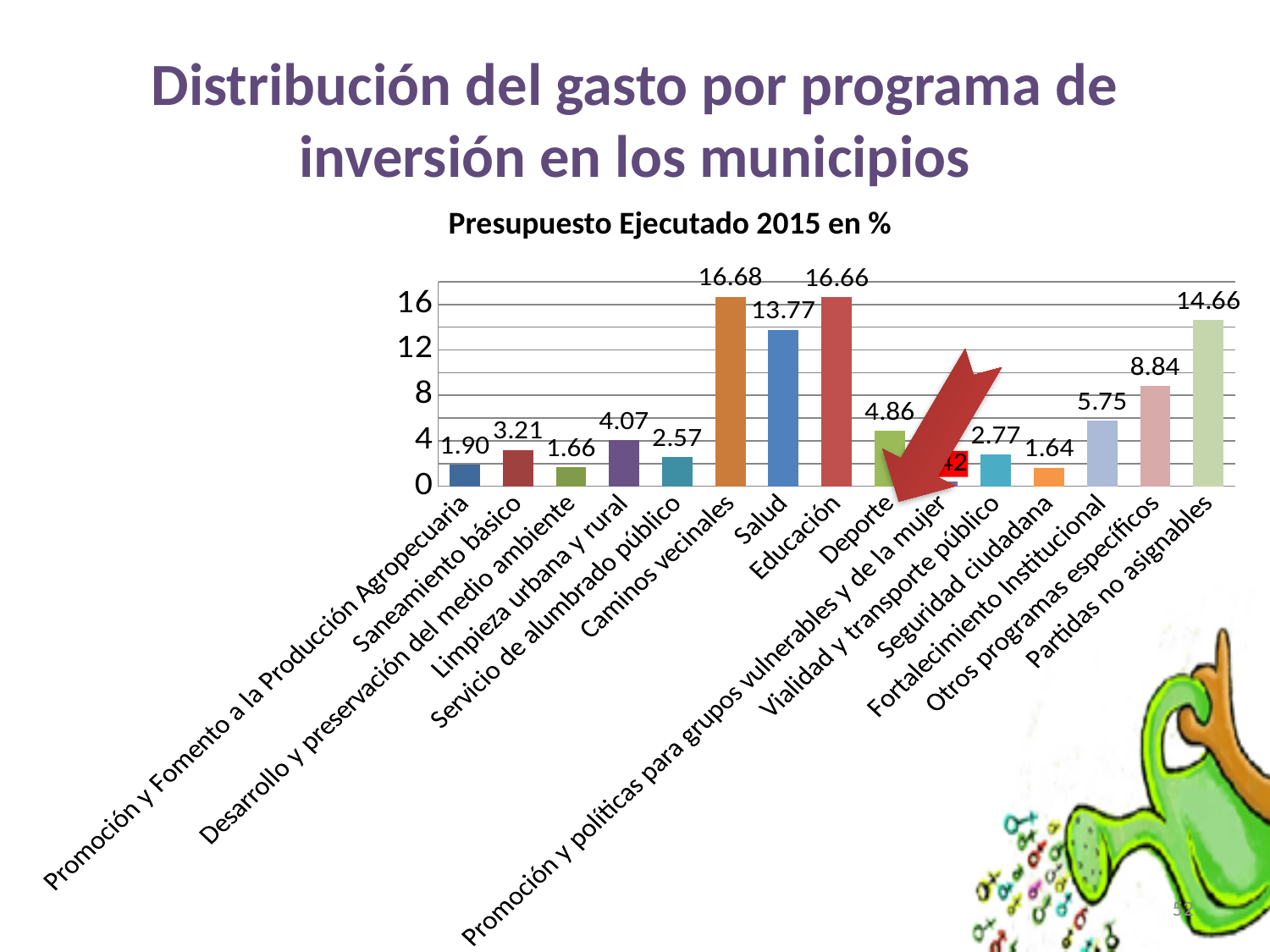
How many categories are shown on the x axis? 15 What is the value for Seguridad ciudadana? 1.64 What is the value for Caminos vecinales? 16.68 What is the value for Deporte? 4.86 What is the title of the chart? Presupuesto Ejecutado 2015 en % What kind of chart is shown on the slide? Bar chart What is the value for Salud? 13.77 Is the value for Otros programas específicos greater or less than 8? greater What is the difference between the values for Salud and Deporte? 8.91 What is the value for Otros programas específicos? 8.84 Which is larger, the value for Fortalecimiento Institucional or the value for Limpieza urbana y rural? Fortalecimiento Institucional What is the value for Partidas no asignables? 14.66